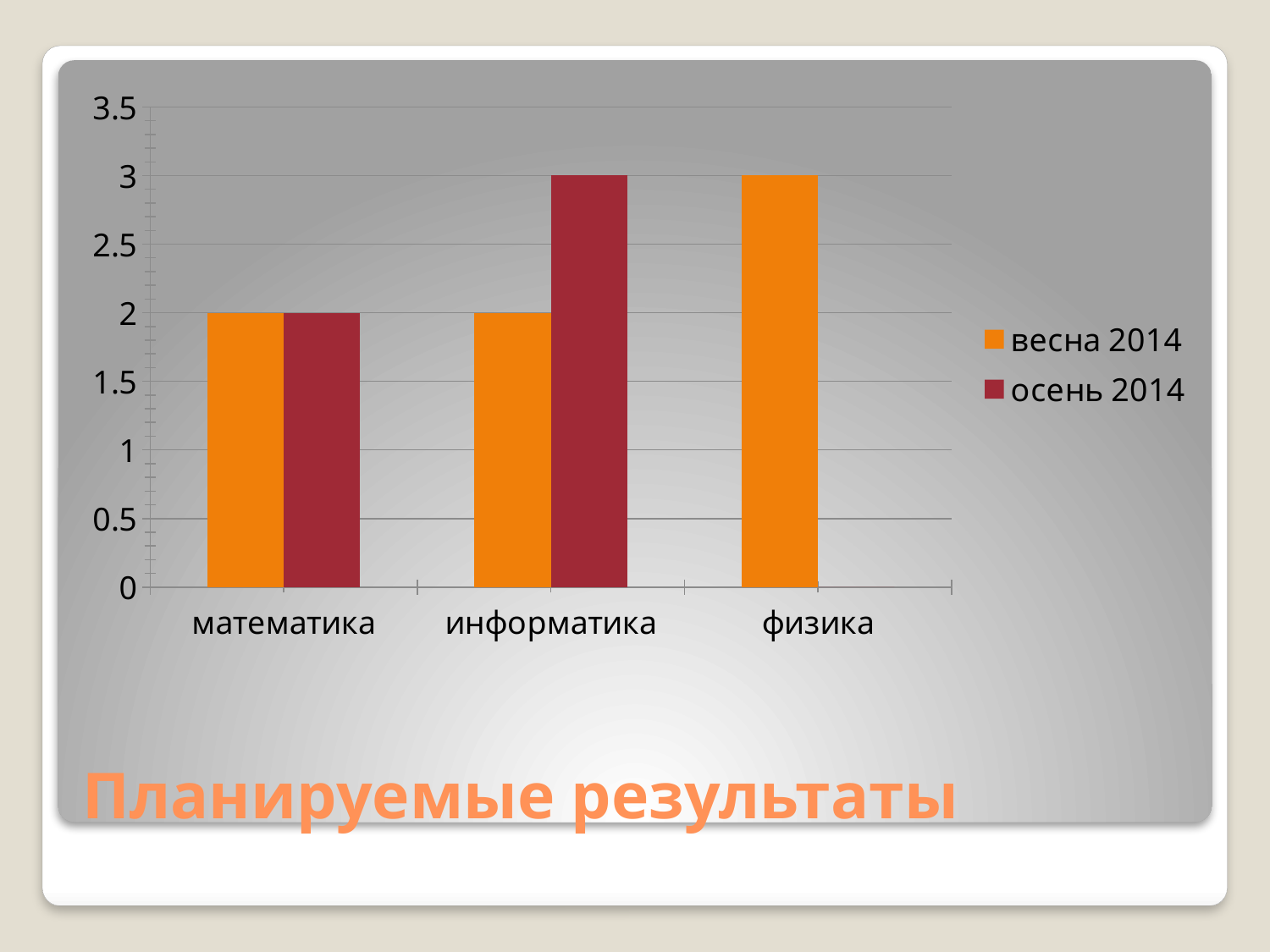
Which is larger for информатика: the весна 2014 value or the осень 2014 value? осень 2014 What colour are the bars for the весна 2014 series? orange Which category has the lowest value in the весна 2014 series? математика and информатика (both 2) Which category has the highest value in the осень 2014 series? информатика How many categories are shown on the x axis? 3 What is the value for физика in the весна 2014 series? 3 What type of chart is shown on the slide? bar chart What is the value for информатика in the осень 2014 series? 3 What is the difference between the осень 2014 and весна 2014 values for информатика? 1 How many series does the legend list? 2 What is the value for математика in the весна 2014 series? 2 What is the value for математика in the осень 2014 series? 2